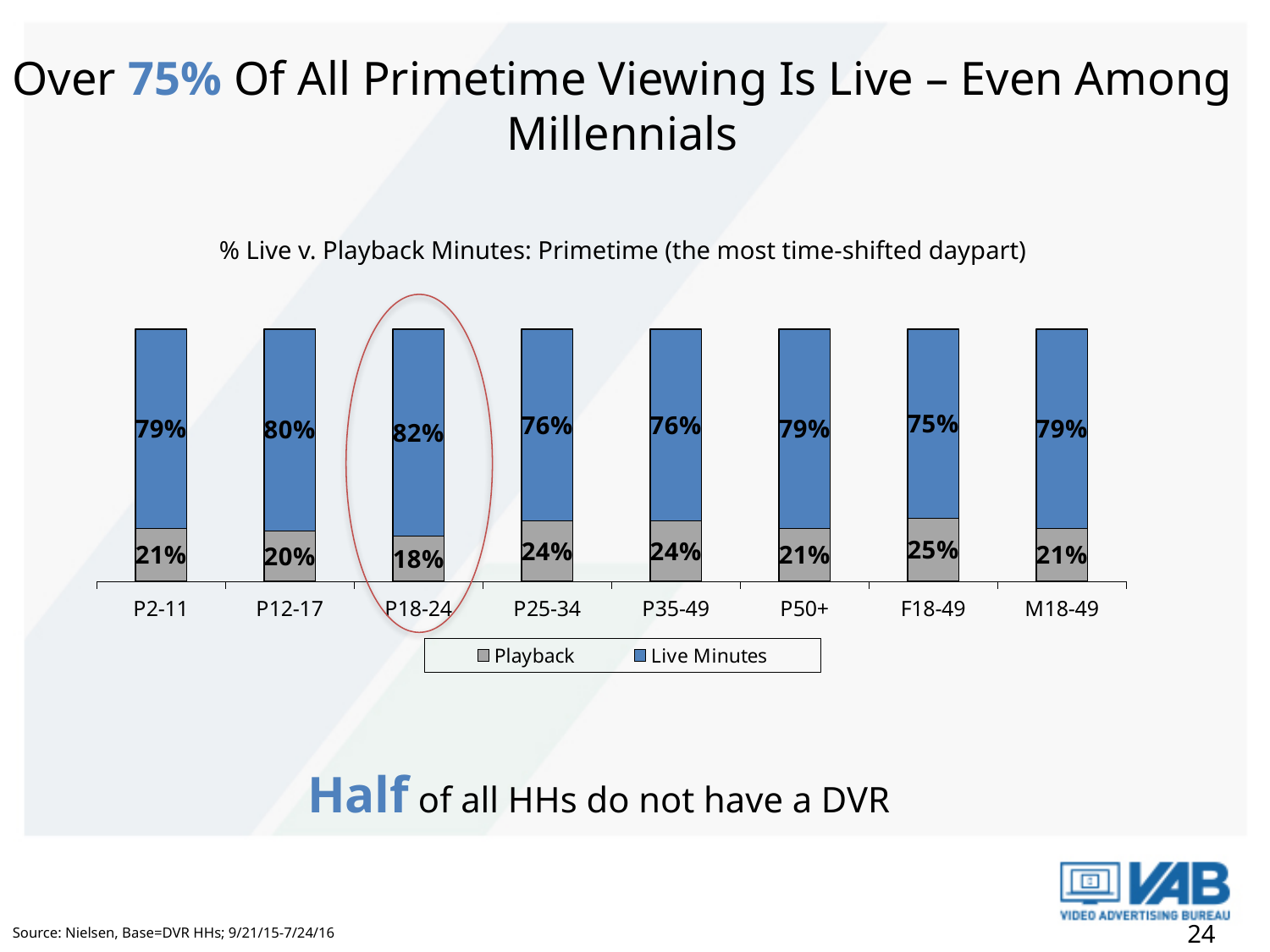
Which category has the highest Playback share? F18-49 What is the Playback value for F18-49? 25% Which category has the highest Live Minutes share? P18-24 What is the Live Minutes value for P18-24? 82% How many series does the legend list? 2 Which is larger, the Playback value for P12-17 or for P35-49? P35-49 What kind of chart is shown on the slide? Stacked bar chart What is the difference between the Live Minutes values for P18-24 and F18-49? 7% How many categories are shown on the x axis? 8 What is the Live Minutes value for M18-49? 79% What is the Playback value for P25-34? 24% Which category has the lowest Playback share? P18-24